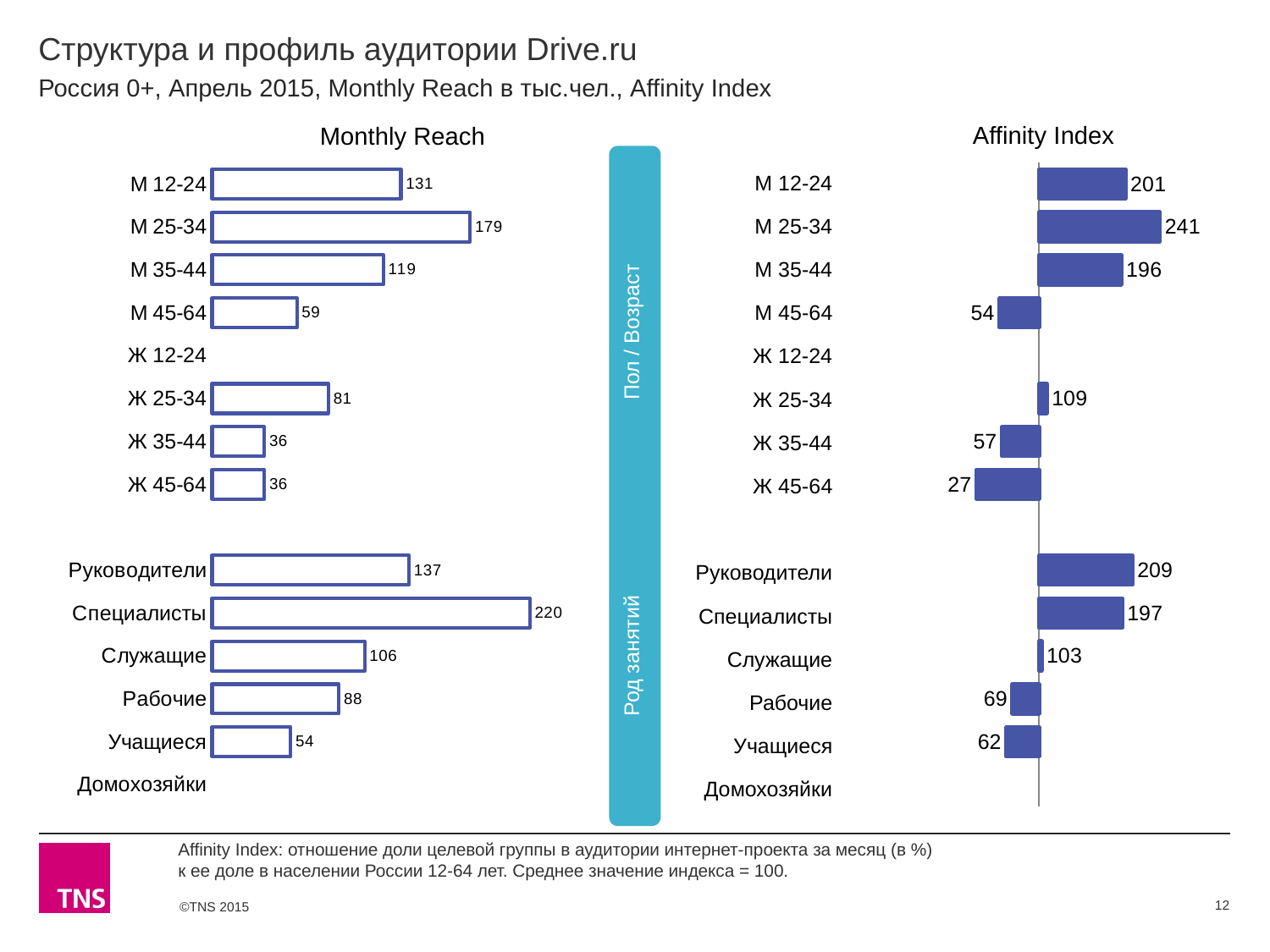
What type of chart is the Monthly Reach chart? Bar chart In the Affinity Index chart, which category has the lowest value among those with a bar? Ж 45-64 In the Affinity Index chart, what is the difference between Специалисты and Служащие? 94 In the Affinity Index chart, which category has the highest value? М 25-34 In the Monthly Reach chart, what is the value for Ж 35-44? 36 In the Monthly Reach chart, what is the value for Учащиеся? 54 In the Monthly Reach chart, which category has the highest value? Специалисты In the Monthly Reach chart, what is the value for М 25-34? 179 In the Affinity Index chart, which is larger: М 12-24 or М 35-44? М 12-24 In the Monthly Reach chart, what is the difference between М 12-24 and М 45-64? 72 In the Affinity Index chart, what is the value for Рабочие? 69 In the Affinity Index chart, what is the value for Руководители? 209